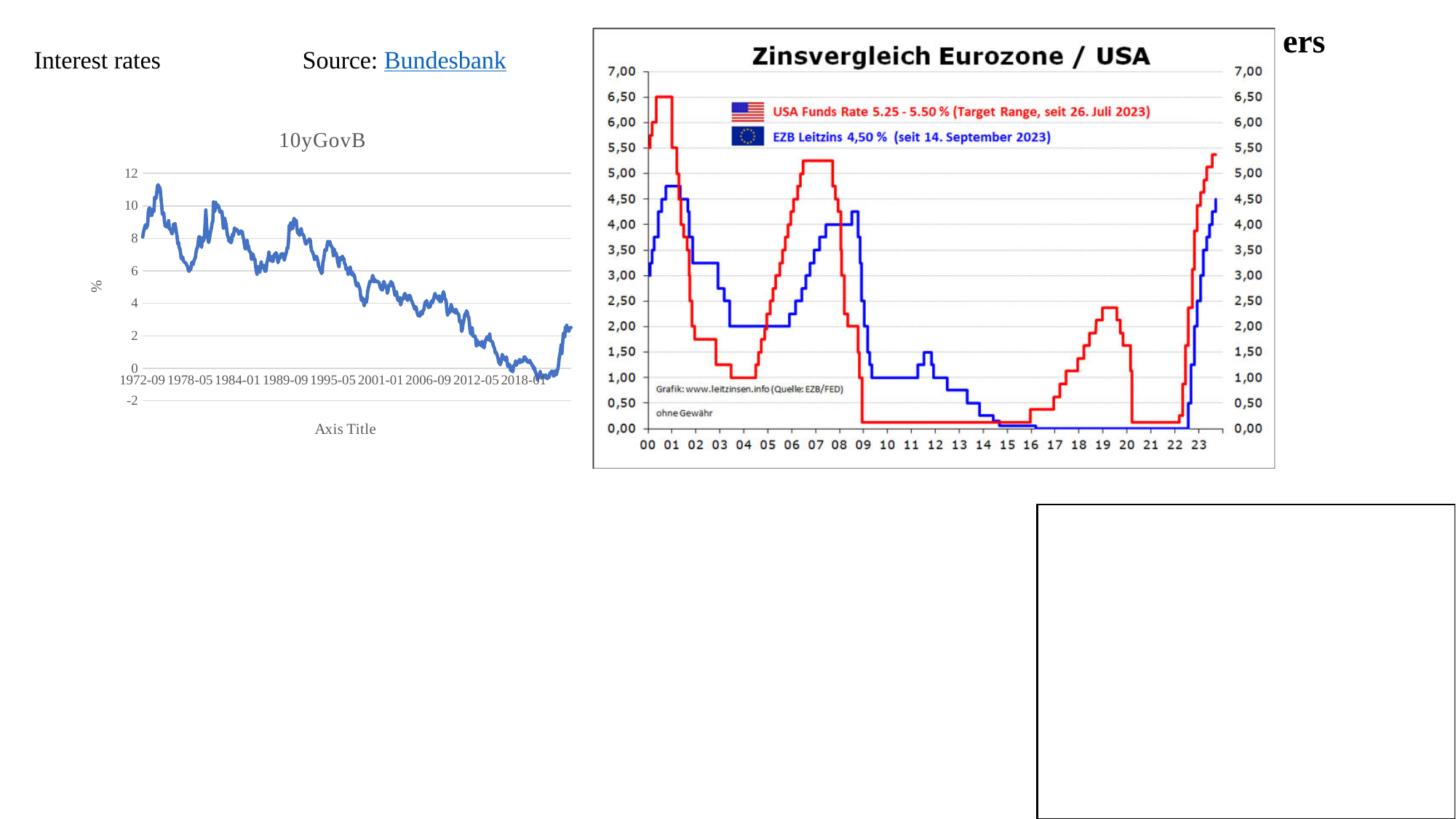
In the right chart (Zinsvergleich Eurozone / USA), what EZB Leitzins value does the legend state? 4,50 % What is the label on the vertical axis of the left chart titled 10yGovB? % In the left chart titled 10yGovB, do the values generally rise or fall from 1972-09 to 2018-01? fall In the right chart (Zinsvergleich Eurozone / USA), is the EZB Leitzins in 2019 greater or less than 0,50? less What is the title of the right chart? Zinsvergleich Eurozone / USA What kind of chart is the left chart titled 10yGovB? line chart How many series does the legend of the right chart (Zinsvergleich Eurozone / USA) list? 2 In the left chart titled 10yGovB, is the value at 2018-01 greater or less than 2? less In the right chart (Zinsvergleich Eurozone / USA), is the USA Funds Rate in 2012 greater or less than 0,50? less In the right chart (Zinsvergleich Eurozone / USA), which series is higher at the end of 2023, USA Funds Rate or EZB Leitzins? USA Funds Rate In the right chart (Zinsvergleich Eurozone / USA), what USA Funds Rate target range does the legend state? 5.25 - 5.50 %